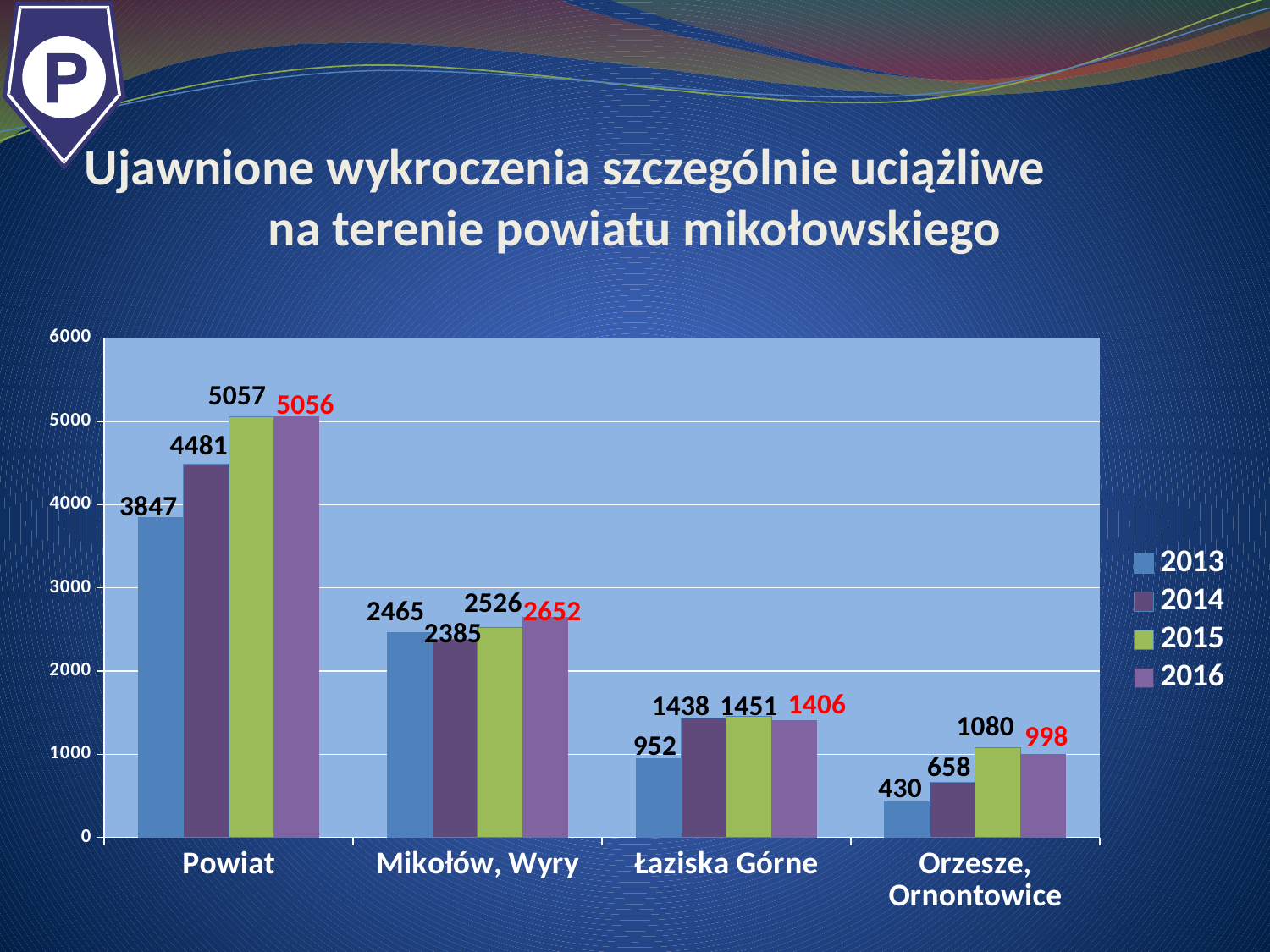
How many series does the legend list? 4 Which category has the lowest value in 2014? Orzesze, Ornontowice What is the value for Orzesze, Ornontowice in 2013? 430 Which is larger for Mikołów, Wyry: the 2013 value or the 2014 value? 2013 What kind of chart is shown on the slide? bar chart What is the value for Powiat in 2016? 5056 Do the values for Orzesze, Ornontowice rise or fall from 2013 to 2015? rise Which category has the highest value in 2015? Powiat Which year's data labels are printed in red? 2016 What is the value for Łaziska Górne in 2015? 1451 What is the difference between the 2015 and 2013 values for Powiat? 1210 How many categories are shown on the x axis? 4